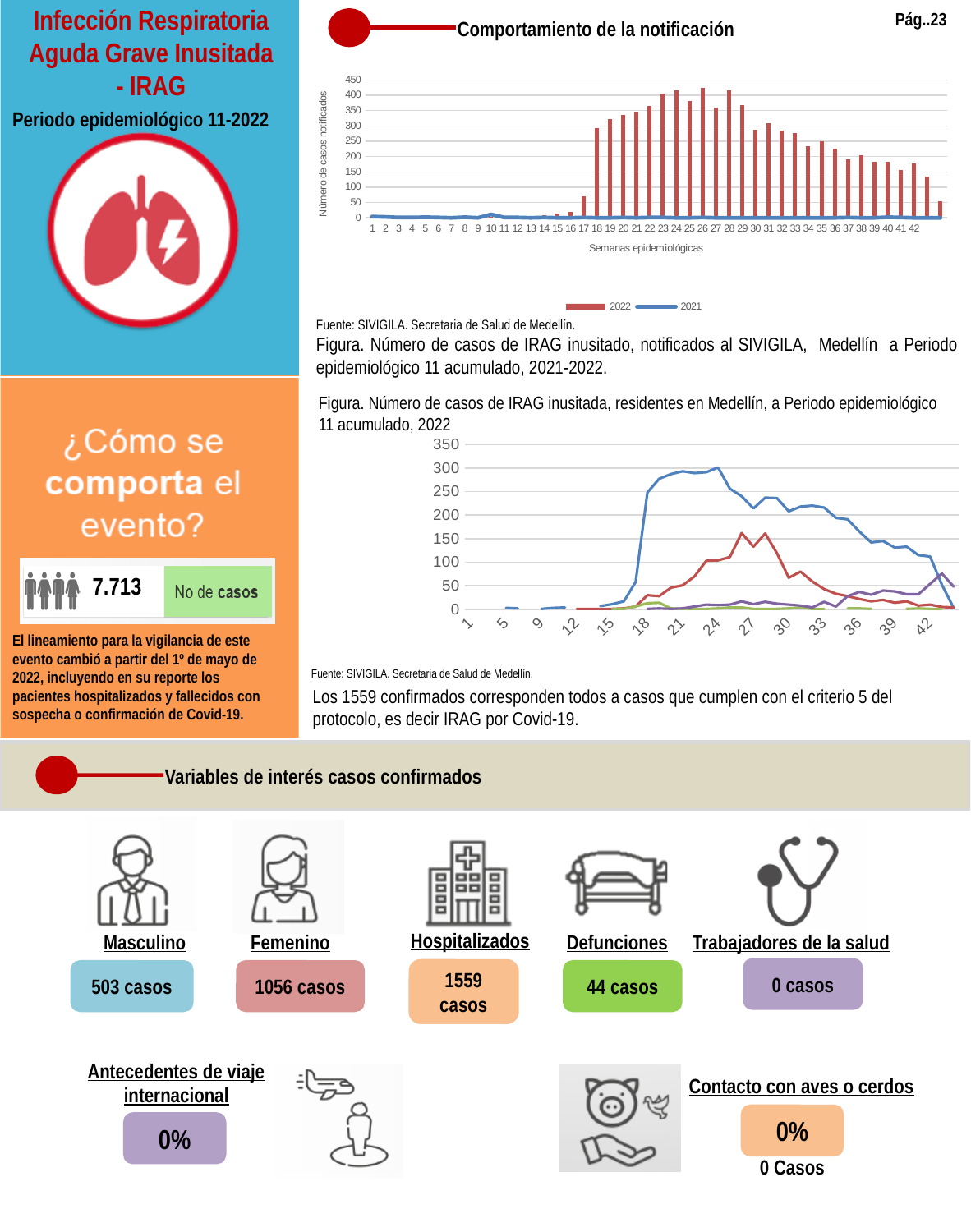
In the top chart 'Comportamiento de la notificación', is the 2022 value for week 42 greater or less than 100? greater In the top chart 'Comportamiento de la notificación', is the 2022 value for week 10 greater or less than 50? less In the top chart 'Comportamiento de la notificación', what is the label of the x axis? Semanas epidemiológicas In the top chart 'Comportamiento de la notificación', how many series does the legend list? 2 In the top chart 'Comportamiento de la notificación', do the 2022 values rise or fall from week 28 to week 42? fall What kind of chart is the bottom chart (casos de IRAG inusitada, residentes en Medellín, 2022)? line chart In the top chart 'Comportamiento de la notificación', which two years are listed in the legend? 2022 and 2021 In the top chart 'Comportamiento de la notificación', which 2022 value is larger, week 20 or week 40? week 20 In the bottom chart (residentes en Medellín, 2022), is the value of the red line at week 27 greater or less than 100? greater